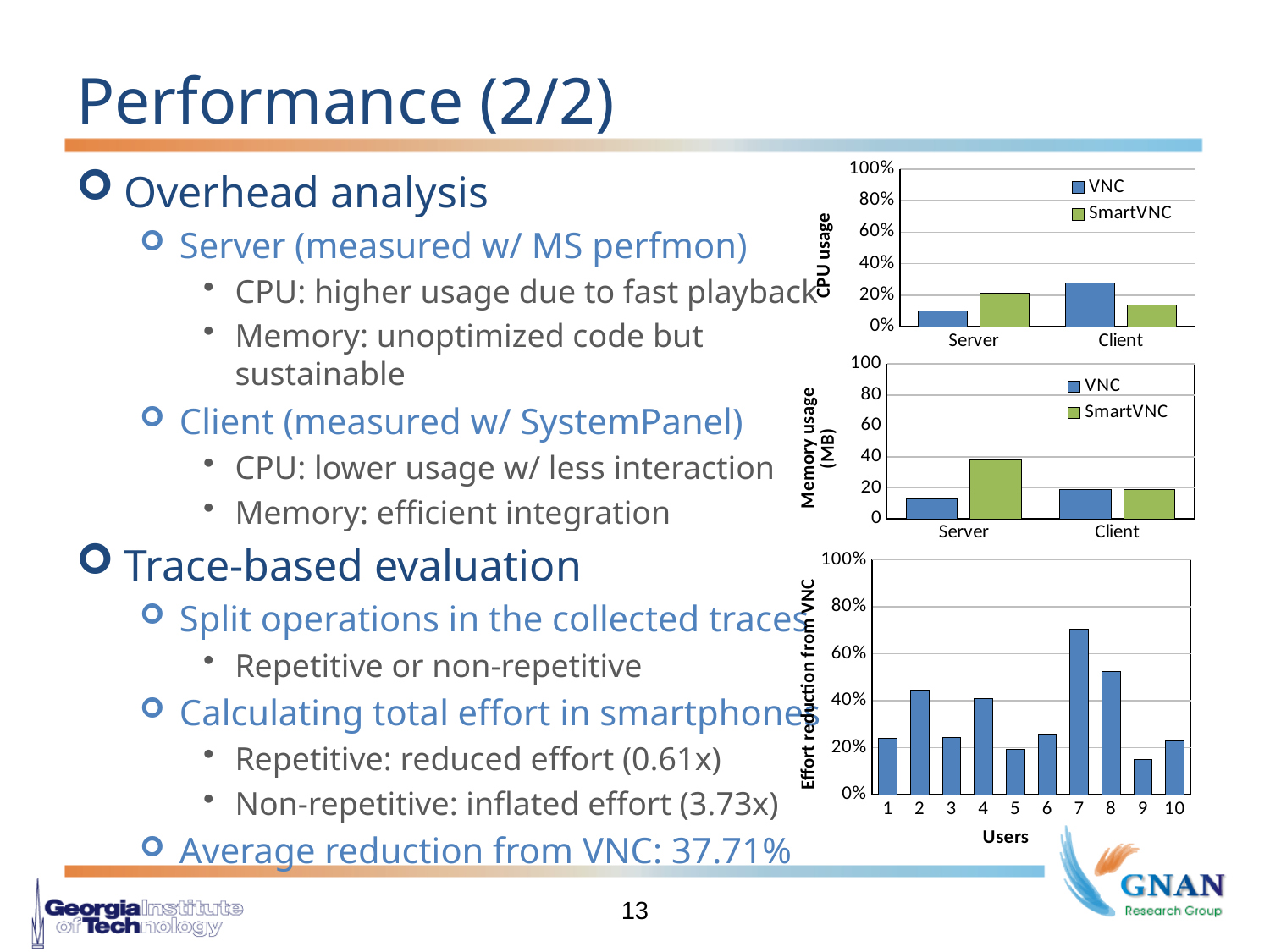
In the Memory usage (MB) chart, which series has the higher value for Server, VNC or SmartVNC? SmartVNC How many series does the legend of the Memory usage (MB) chart list? 2 In the CPU usage chart, is the VNC value for Server greater or less than 20%? less In the CPU usage chart, is the VNC value for Client greater or less than 20%? greater In the Effort reduction from VNC chart, is the value for user 8 greater or less than 40%? greater In the Effort reduction from VNC chart, which user has the lowest effort reduction? 9 In the CPU usage chart, which series has the higher value for Server, VNC or SmartVNC? SmartVNC What kind of chart is the Effort reduction from VNC chart? bar chart In the CPU usage chart, which series has the higher value for Client, VNC or SmartVNC? VNC In the Effort reduction from VNC chart, which user has the highest effort reduction? 7 How many users are shown on the x axis of the Effort reduction from VNC chart? 10